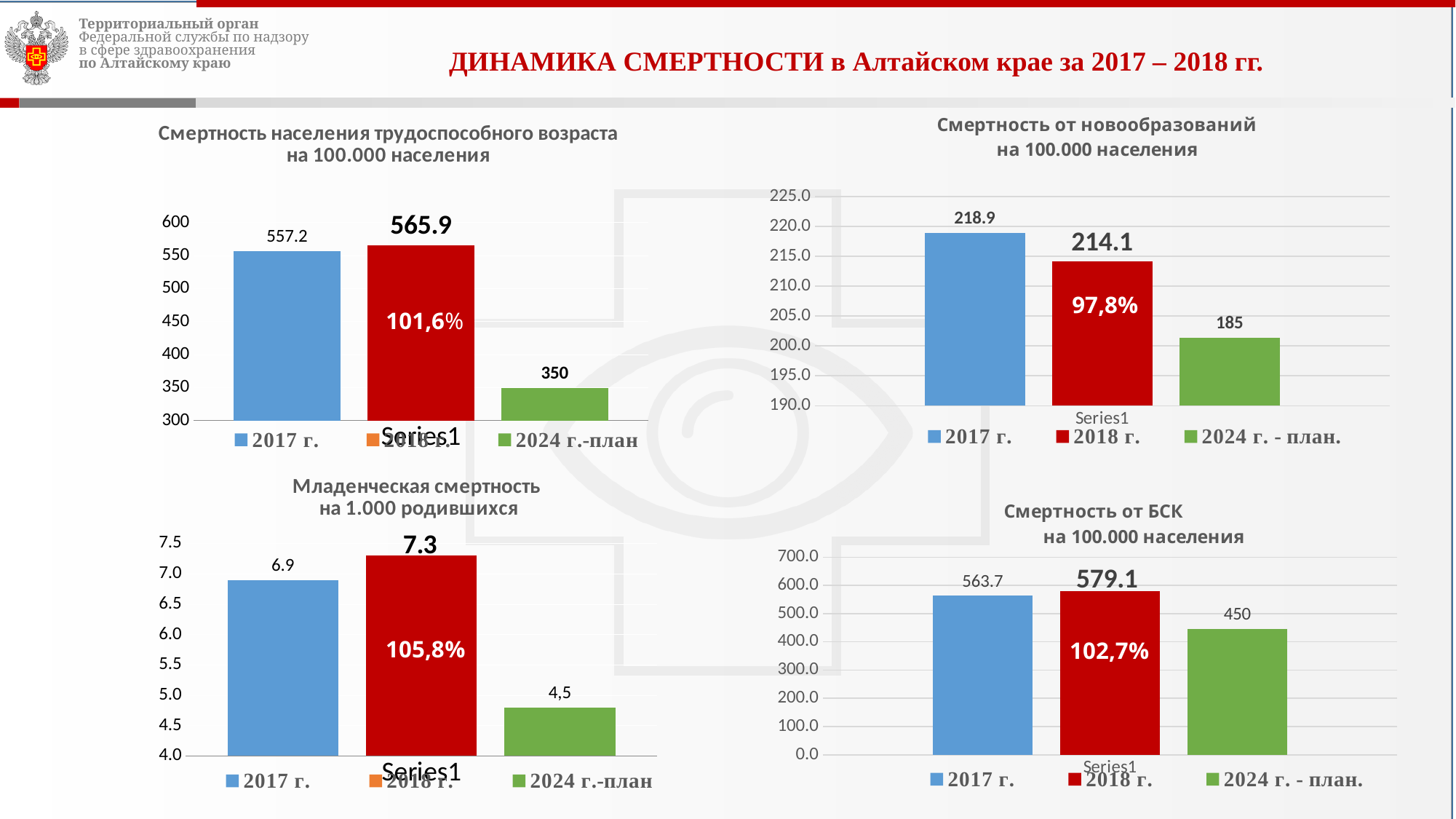
In the chart 'Смертность населения трудоспособного возраста на 100.000 населения', what is the value for 2017 г.? 557.2 In the chart 'Смертность от новообразований на 100.000 населения', what is the difference between the 2017 г. and 2018 г. values? 4.8 What type of chart is 'Младенческая смертность на 1.000 родившихся'? Bar chart In the chart 'Младенческая смертность на 1.000 родившихся', what is the value for 2018 г.? 7.3 In the chart 'Смертность населения трудоспособного возраста на 100.000 населения', what is the difference between the 2018 г. and 2017 г. values? 8.7 How many bars are plotted in the chart 'Смертность от БСК на 100.000 населения'? 3 In the chart 'Смертность от новообразований на 100.000 населения', what is the value for 2024 г. - план.? 185 In the chart 'Младенческая смертность на 1.000 родившихся', which bar is the lowest? 2024 г.-план In the chart 'Смертность населения трудоспособного возраста на 100.000 населения', which bar is the highest? 2018 г. In the chart 'Смертность от БСК на 100.000 населения', what is the value for 2017 г.? 563.7 In the chart 'Смертность от БСК на 100.000 населения', what is the difference between the 2018 г. and 2017 г. values? 15.4 In the chart 'Смертность от новообразований на 100.000 населения', which is larger, the 2017 г. value or the 2018 г. value? 2017 г.